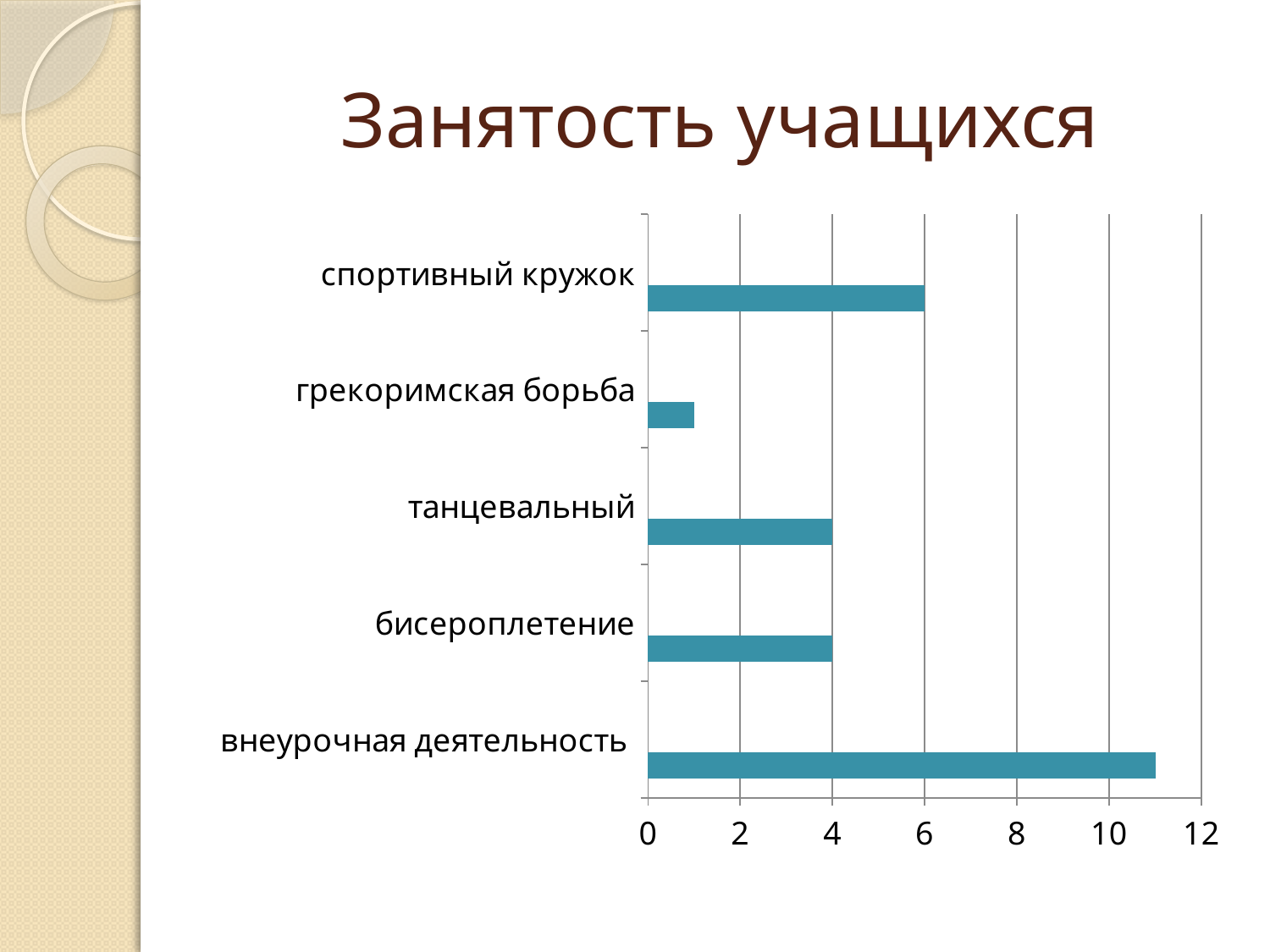
What is the value for танцевальный? 4 Which is larger, the value for спортивный кружок or the value for бисероплетение? спортивный кружок Which category has the highest value? внеурочная деятельность Is the value for грекоримская борьба greater or less than 2? less What is the title of the chart? Занятость учащихся What is the value for спортивный кружок? 6 Is the value for внеурочная деятельность greater or less than 10? greater What is the difference between the values for спортивный кружок and танцевальный? 2 What type of chart is shown on the slide? bar chart What is the value for бисероплетение? 4 Which category has the lowest value? грекоримская борьба How many categories are shown in the chart? 5